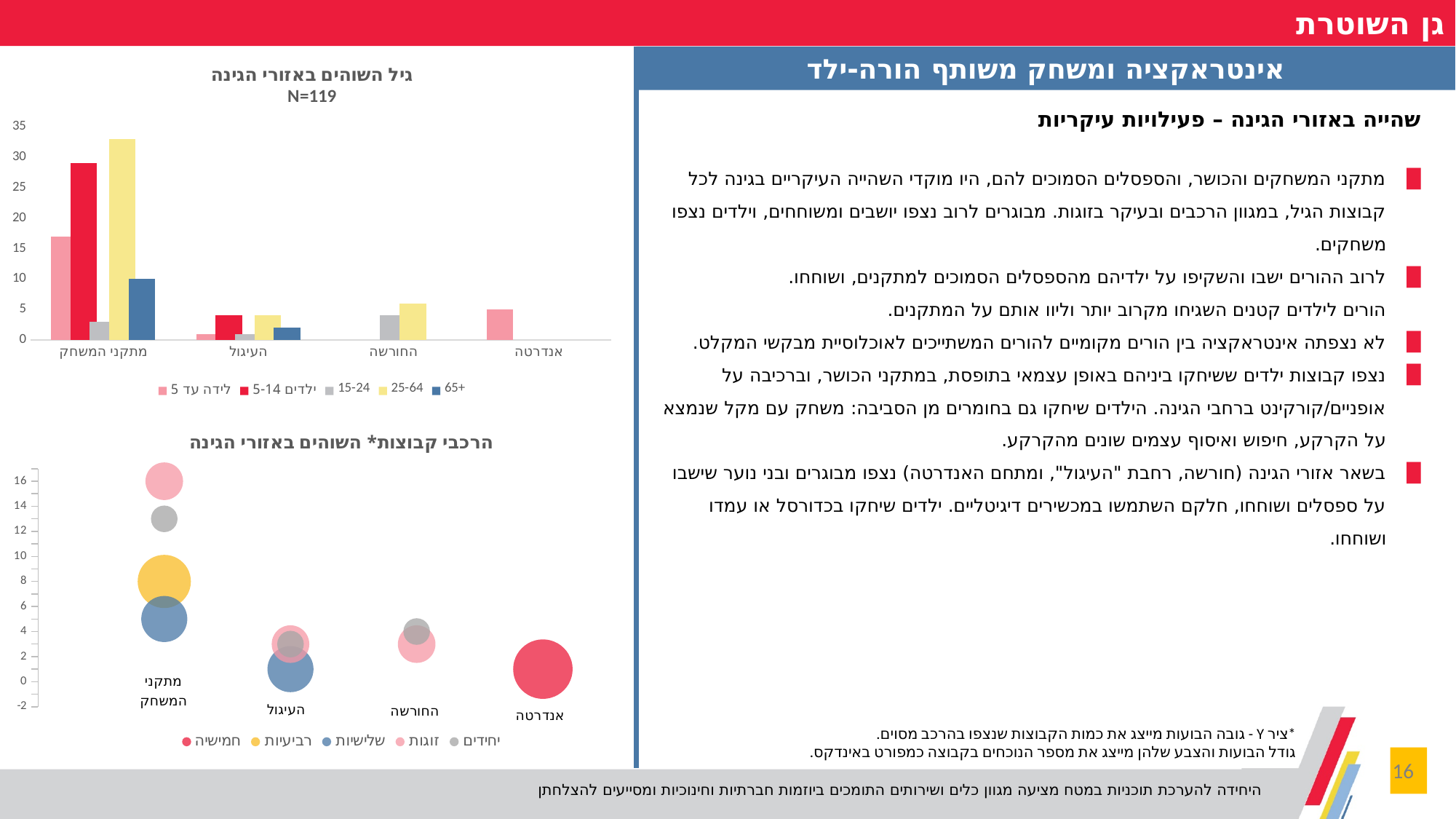
What sample size (N) is shown under the title of the chart 'גיל השוהים באזורי הגינה'? N=119 In the chart 'גיל השוהים באזורי הגינה', is the value for 25-64 at מתקני המשחק greater or less than 30? greater In the chart 'הרכבי קבוצות* השוהים באזורי הגינה', how many series does the legend list? 5 In the chart 'גיל השוהים באזורי הגינה', how many categories are shown on the x axis? 4 What kind of chart is the bottom-left chart titled 'הרכבי קבוצות* השוהים באזורי הגינה'? bubble chart In the chart 'גיל השוהים באזורי הגינה', how many series does the legend list? 5 In the chart 'גיל השוהים באזורי הגינה', which category has the fewest age groups with visible bars? אנדרטה What kind of chart is the top-left chart titled 'גיל השוהים באזורי הגינה'? bar chart In the chart 'גיל השוהים באזורי הגינה', is the value for לידה עד 5 at מתקני המשחק greater or less than 20? less In the chart 'הרכבי קבוצות* השוהים באזורי הגינה', which colour represents the series חמישיה? red In the chart 'גיל השוהים באזורי הגינה', which age group has the highest bar for מתקני המשחק? 25-64 In the chart 'גיל השוהים באזורי הגינה', which is larger at מתקני המשחק: the bar for ילדים 5-14 or the bar for 65+? ילדים 5-14